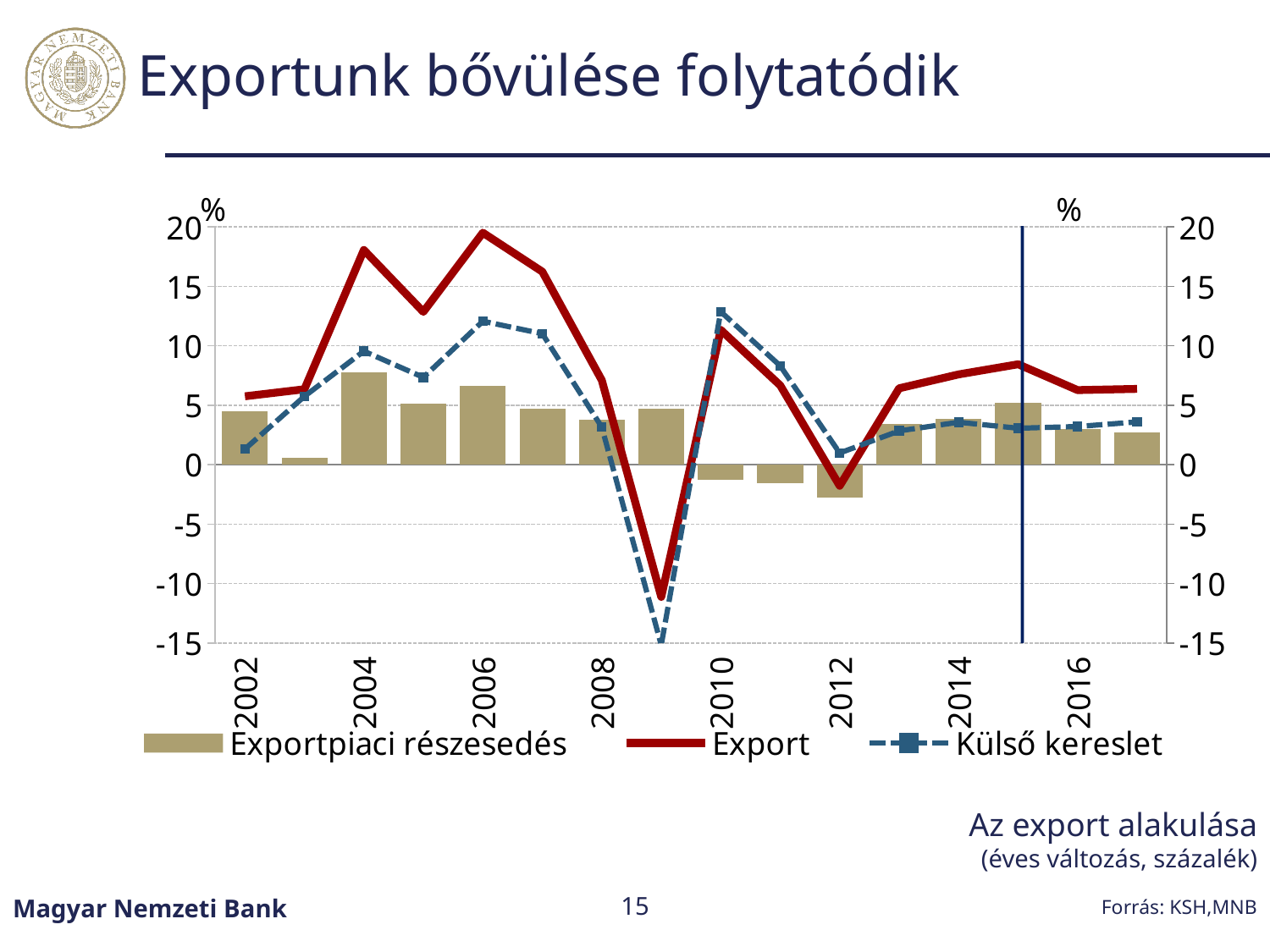
In 2010, which is higher: Export or Külső kereslet? Külső kereslet Is the value of Külső kereslet in 2009 greater or less than -10? less In which year is the Exportpiaci részesedés bar the tallest? 2004 Is the value of Export in 2004 greater or less than 15? greater In which year does the Export line reach its highest value? 2006 In which year is the Exportpiaci részesedés bar the lowest (most negative)? 2012 Which series are listed in the legend? Exportpiaci részesedés, Export, Külső kereslet How many series does the legend list? 3 Does the Export line rise or fall between 2006 and 2009? It falls In which year does the Export line reach its lowest value? 2009 In which year does the Külső kereslet line reach its lowest value? 2009 What kind of chart is shown on the slide? A combined bar and line chart